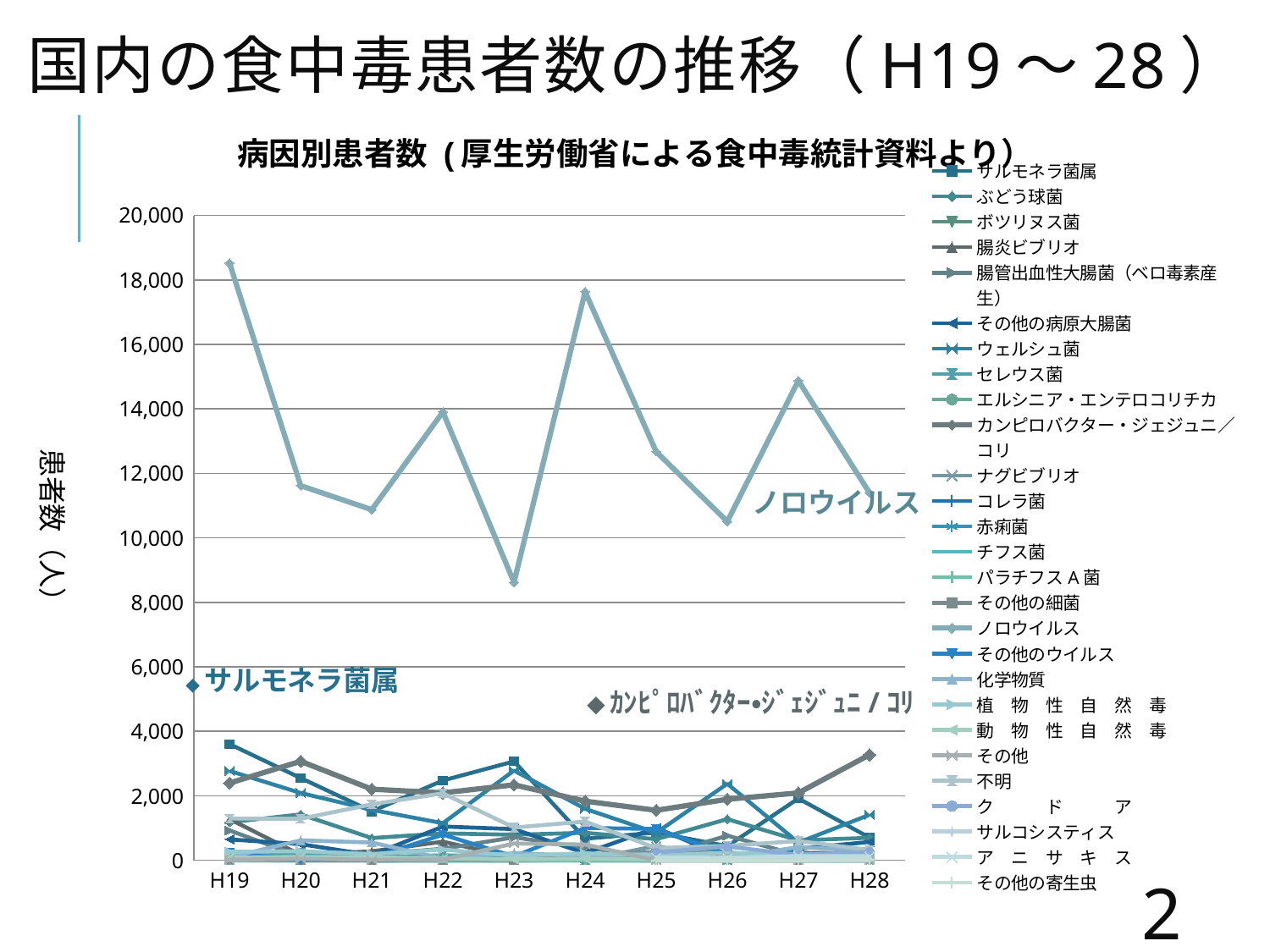
How many series does the chart's legend list? 27 In which year does the ノロウイルス series reach its lowest value? H23 Is the value for ノロウイルス in H19 greater or less than 18,000? greater What is the title of the chart? 病因別患者数（厚生労働省による食中毒統計資料より） Which is larger for ノロウイルス: the value in H24 or the value in H27? H24 Is the value for ノロウイルス in H24 greater or less than 16,000? greater In which year does the ノロウイルス series reach its highest value? H19 What kind of chart is shown on the slide? line chart What is the label on the vertical axis of the chart? 患者数（人） Does the ノロウイルス series rise or fall from H19 to H20? fall How many years (points) are shown along the x axis of the chart? 10 Is the value for ノロウイルス in H23 greater or less than 10,000? less